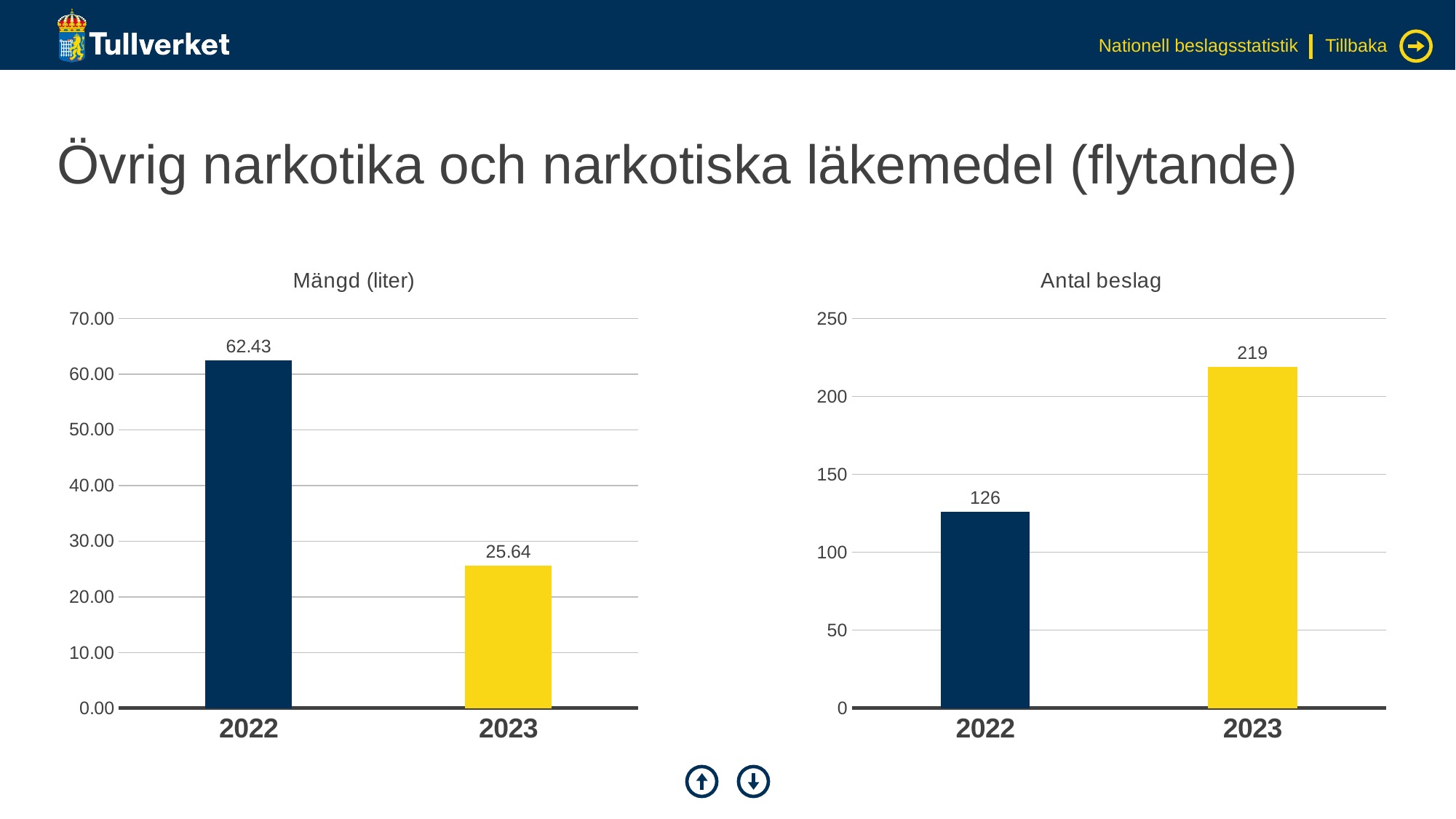
In the 'Antal beslag' chart, what is the value for 2022? 126 In the 'Mängd (liter)' chart, which year has the highest value? 2022 How many categories are shown on the x axis of the 'Mängd (liter)' chart? 2 What kind of chart is the 'Antal beslag' chart? bar chart In the 'Antal beslag' chart, what is the difference between the 2023 and 2022 values? 93 In the 'Antal beslag' chart, what is the value for 2023? 219 In the 'Mängd (liter)' chart, do the values rise or fall from 2022 to 2023? fall In the 'Mängd (liter)' chart, what is the value for 2023? 25.64 In the 'Antal beslag' chart, is the value for 2022 greater or less than 150? less In the 'Mängd (liter)' chart, what is the difference between the 2022 and 2023 values? 36.79 In the 'Antal beslag' chart, which year has the lowest value? 2022 In the 'Mängd (liter)' chart, what is the value for 2022? 62.43